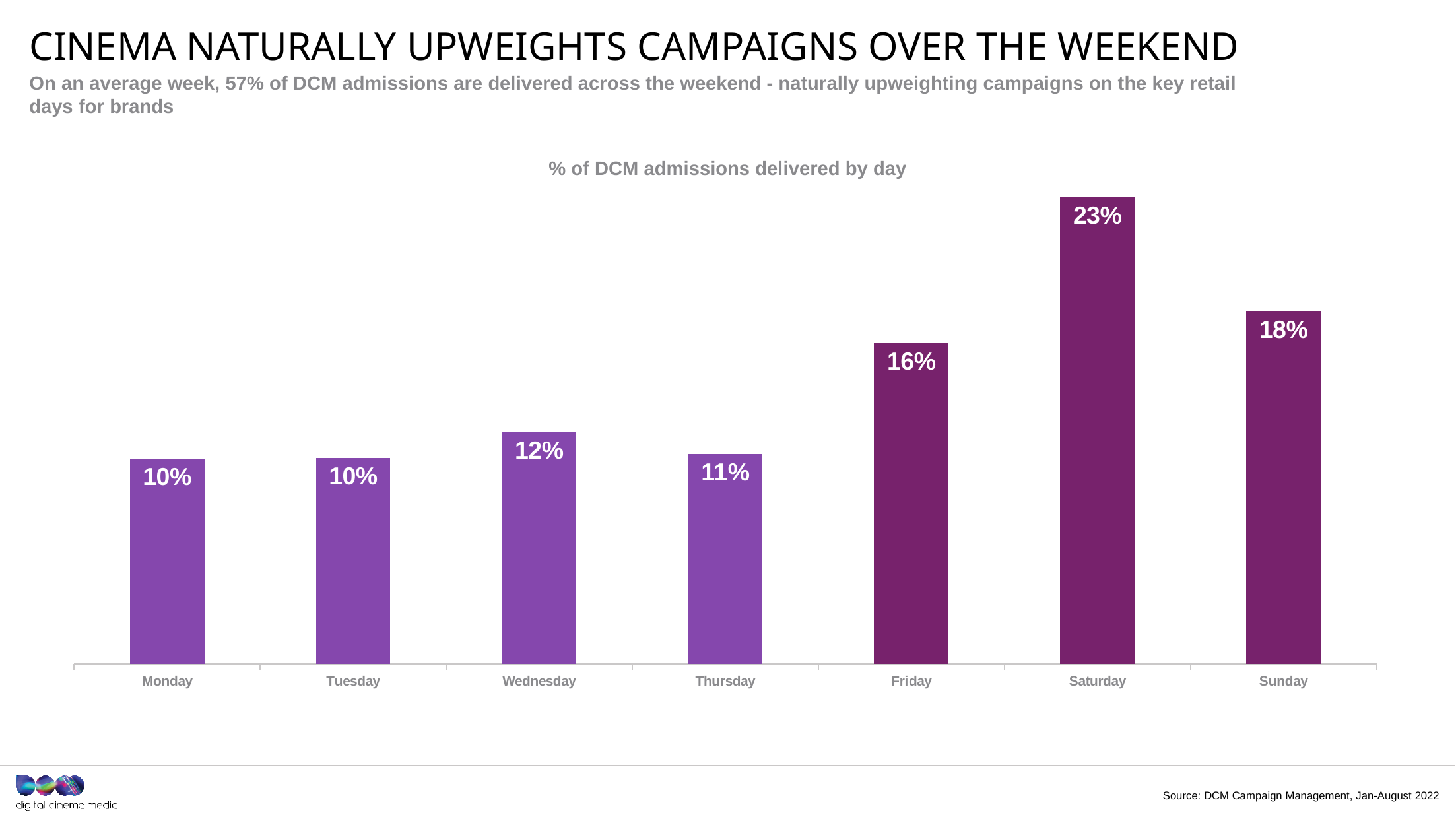
Which is larger, the value for Wednesday or the value for Thursday? Wednesday How many days are shown on the x axis of the chart? 7 Which is larger, the value for Friday or the value for Sunday? Sunday What is the difference between the Saturday and Friday values? 7% Which day has the highest share of DCM admissions? Saturday What is the combined value for Friday, Saturday and Sunday? 57% What is the difference between the Sunday and Thursday values? 7% What percentage of DCM admissions is delivered on Wednesday? 12% What percentage of DCM admissions is delivered on Saturday? 23% What kind of chart is shown on the slide? Bar chart What percentage of DCM admissions is delivered on Sunday? 18% What is the title of the chart? % of DCM admissions delivered by day